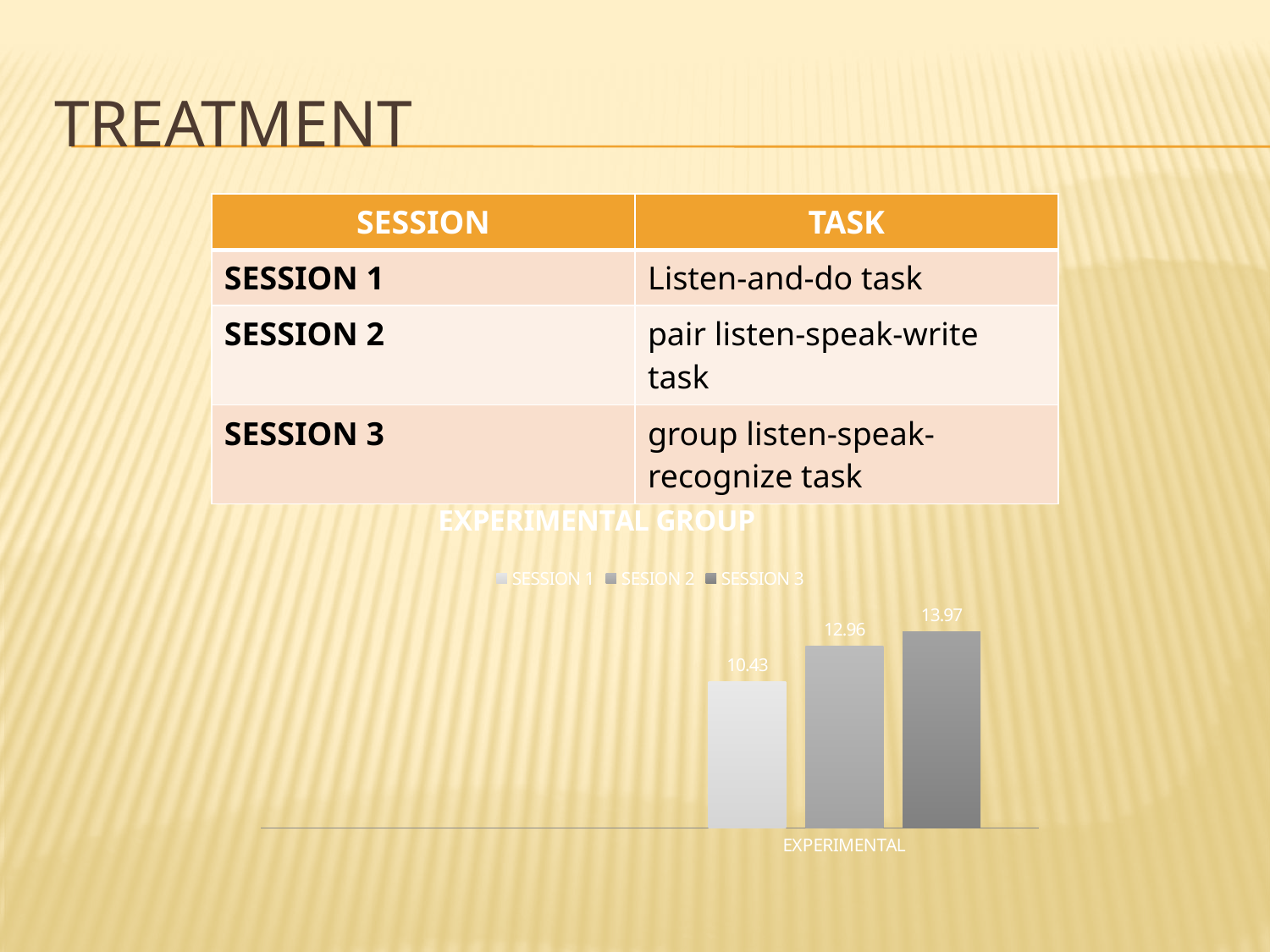
What type of chart is shown on the slide? bar chart Which is larger, the value for Session 2 or the value for Session 3? Session 3 What is the category label shown on the x axis of the chart? EXPERIMENTAL What is the difference between the Session 2 and Session 1 values? 2.53 What is the value for Session 3 in the Experimental group? 13.97 How many series does the chart legend list? 3 Which session has the lowest value in the chart? Session 1 What is the value for Session 1 in the Experimental group? 10.43 What is the title of the chart? EXPERIMENTAL GROUP Which session has the highest value in the chart? Session 3 What is the difference between the Session 3 and Session 1 values? 3.54 What is the value for Session 2 in the Experimental group? 12.96